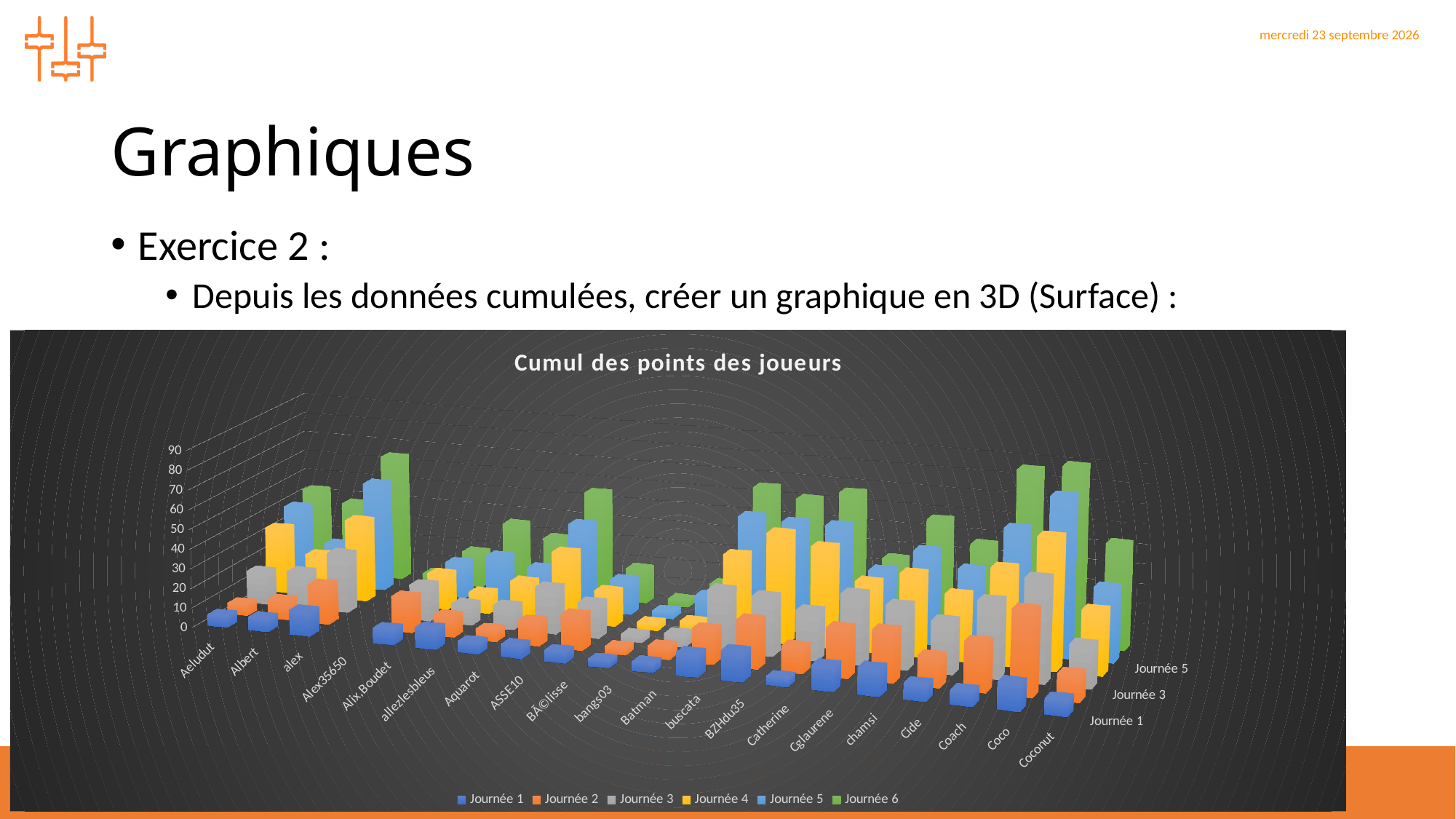
Which is larger, the Journée 6 value for Coco or for Aeludut? Coco What is the highest value shown on the vertical axis? 90 What kind of chart is shown on the slide? bar chart Which colour represents Journée 6 in the legend? green Is the Journée 6 value for Coco greater or less than 40? greater What is the title of the chart? Cumul des points des joueurs How many series does the legend list? 6 How many player categories are shown along the x axis? 20 Is the Journée 6 value for Batman greater or less than 50? less